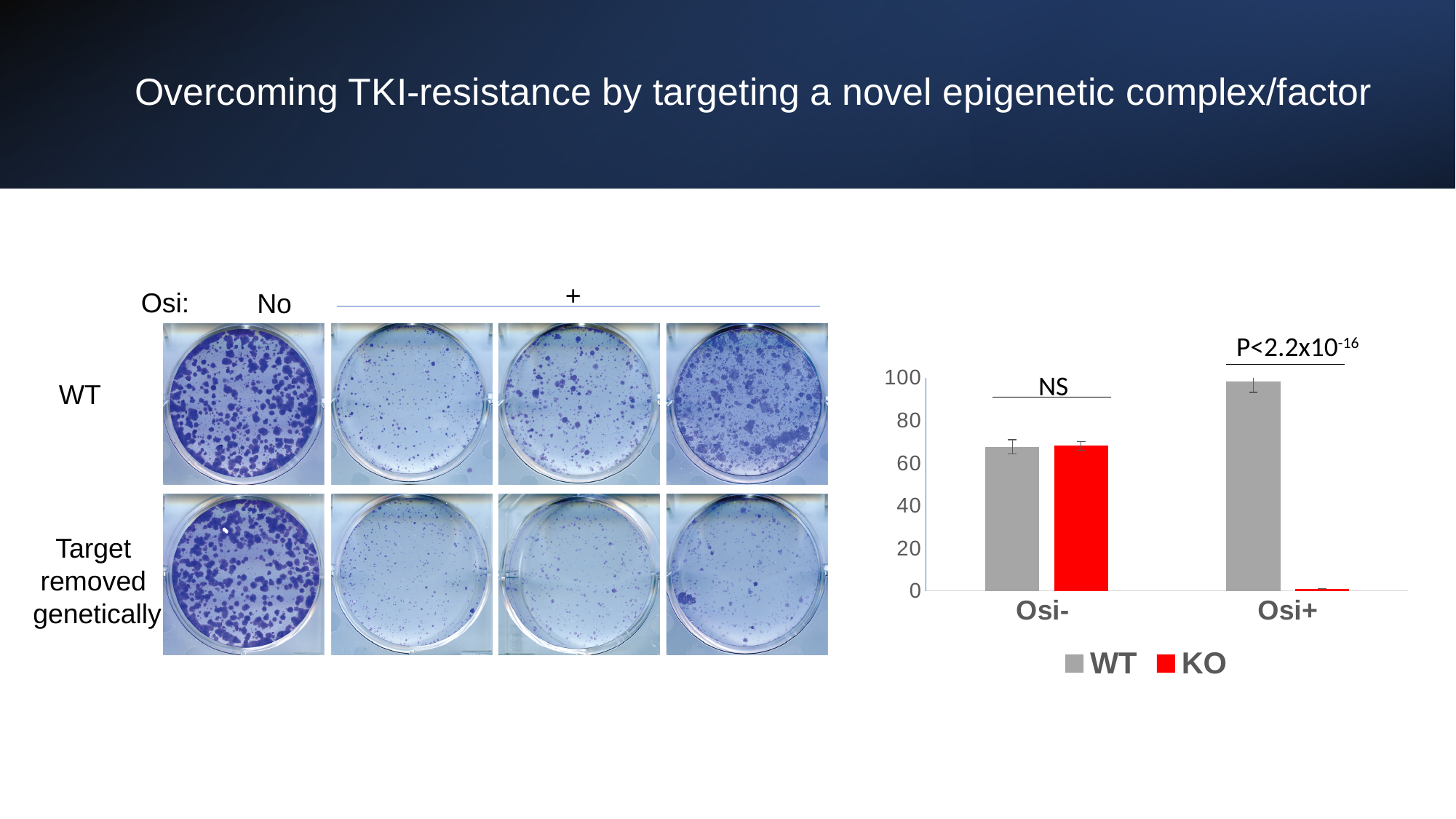
In the bar chart, which is larger at Osi+: WT or KO? WT What kind of chart is shown on the right of the slide? bar chart In the bar chart, is the value for KO at Osi+ greater or less than 20? less In the bar chart, is the value for KO at Osi- greater or less than 80? less In the bar chart, which series and category has the lowest bar? KO at Osi+ What colour represents the KO series in the bar chart? red In the bar chart, is the value for WT at Osi+ greater or less than 80? greater In the bar chart, which series has the highest bar overall? WT How many series does the legend of the bar chart list? 2 How many categories are shown on the x axis of the bar chart? 2 What annotation is written above the Osi- bars in the bar chart? NS